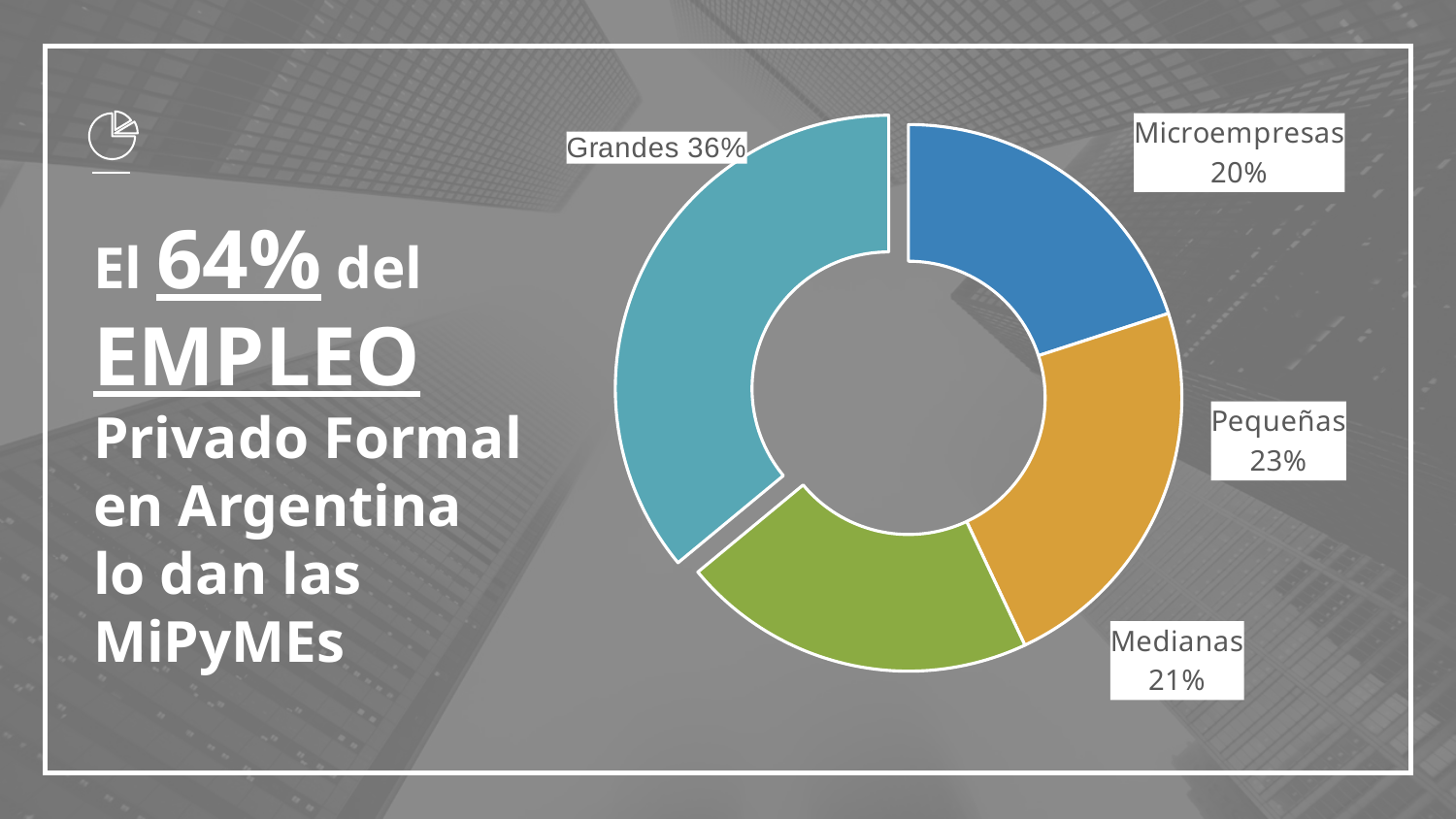
What is the combined share of Microempresas, Pequeñas and Medianas? 64% Which category has the smallest share of the chart? Microempresas Which is larger, the share for Pequeñas or the share for Medianas? Pequeñas What share of the doughnut chart is labelled Grandes? 36% What is the difference in percentage points between Grandes and Pequeñas? 13 Which category has the largest share of the chart? Grandes How many categories does the chart show? 4 What percentage is shown for Pequeñas? 23% What percentage is shown for Microempresas? 20% What percentage is shown for Medianas? 21% What is the difference in percentage points between Pequeñas and Microempresas? 3 What kind of chart is shown on the slide? Doughnut chart